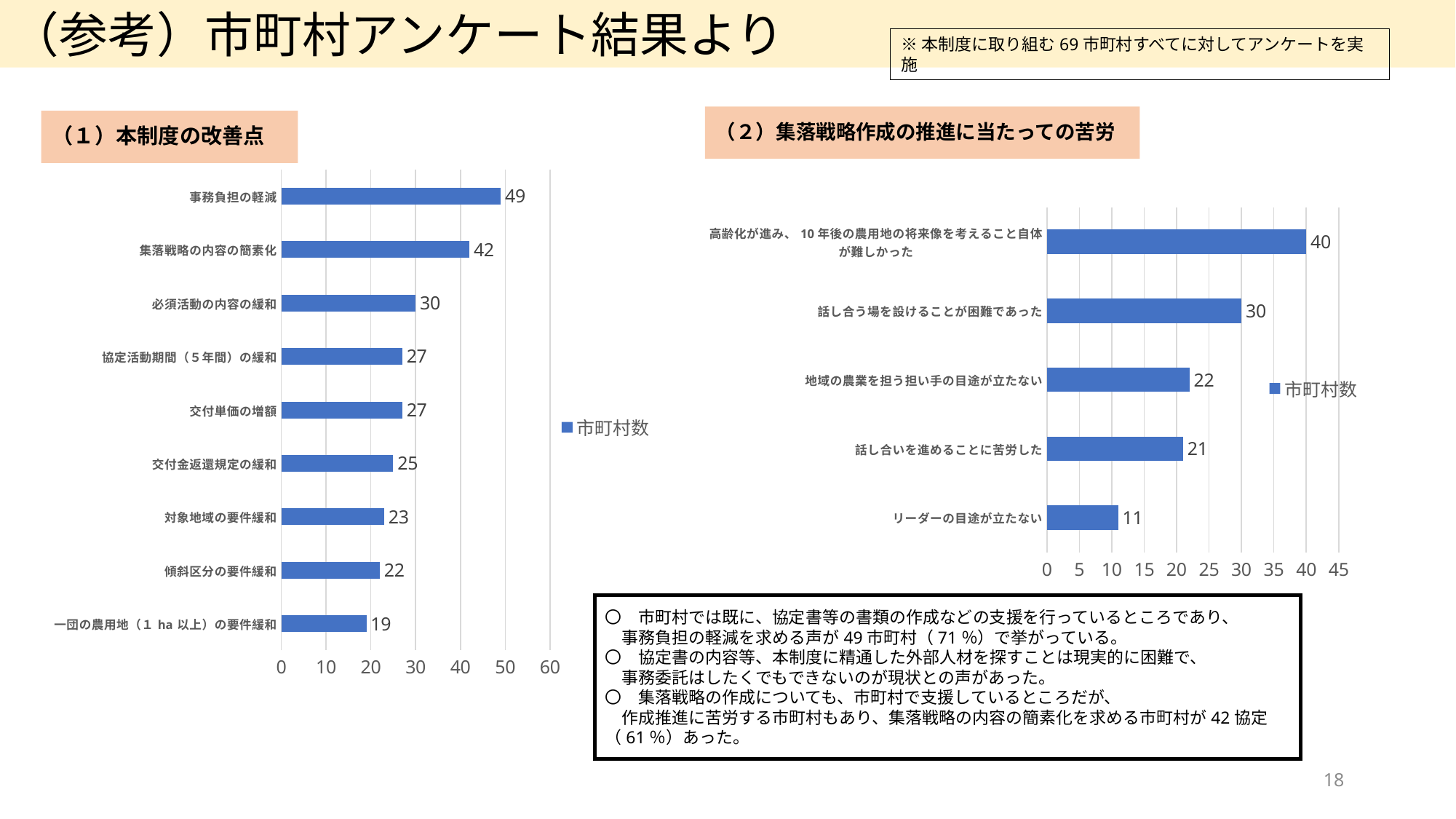
In the chart titled （２）集落戦略作成の推進に当たっての苦労, how many categories are plotted? 5 In the chart titled （１）本制度の改善点, which is larger: 交付金返還規定の緩和 or 対象地域の要件緩和? 交付金返還規定の緩和 In the chart titled （１）本制度の改善点, how many categories are plotted? 9 In the chart titled （１）本制度の改善点, what is the value for 事務負担の軽減? 49 In the chart titled （２）集落戦略作成の推進に当たっての苦労, which category has the highest value? 高齢化が進み、10年後の農用地の将来像を考えること自体が難しかった In the chart titled （２）集落戦略作成の推進に当たっての苦労, what is the value for リーダーの目途が立たない? 11 What type of chart is the chart titled （２）集落戦略作成の推進に当たっての苦労? Bar chart What is the legend entry shown for the chart titled （１）本制度の改善点? 市町村数 In the chart titled （１）本制度の改善点, what is the value for 傾斜区分の要件緩和? 22 In the chart titled （２）集落戦略作成の推進に当たっての苦労, what is the difference between 話し合う場を設けることが困難であった and 話し合いを進めることに苦労した? 9 In the chart titled （１）本制度の改善点, which category has the lowest value? 一団の農用地（１ha以上）の要件緩和 In the chart titled （１）本制度の改善点, what is the difference between 事務負担の軽減 and 集落戦略の内容の簡素化? 7